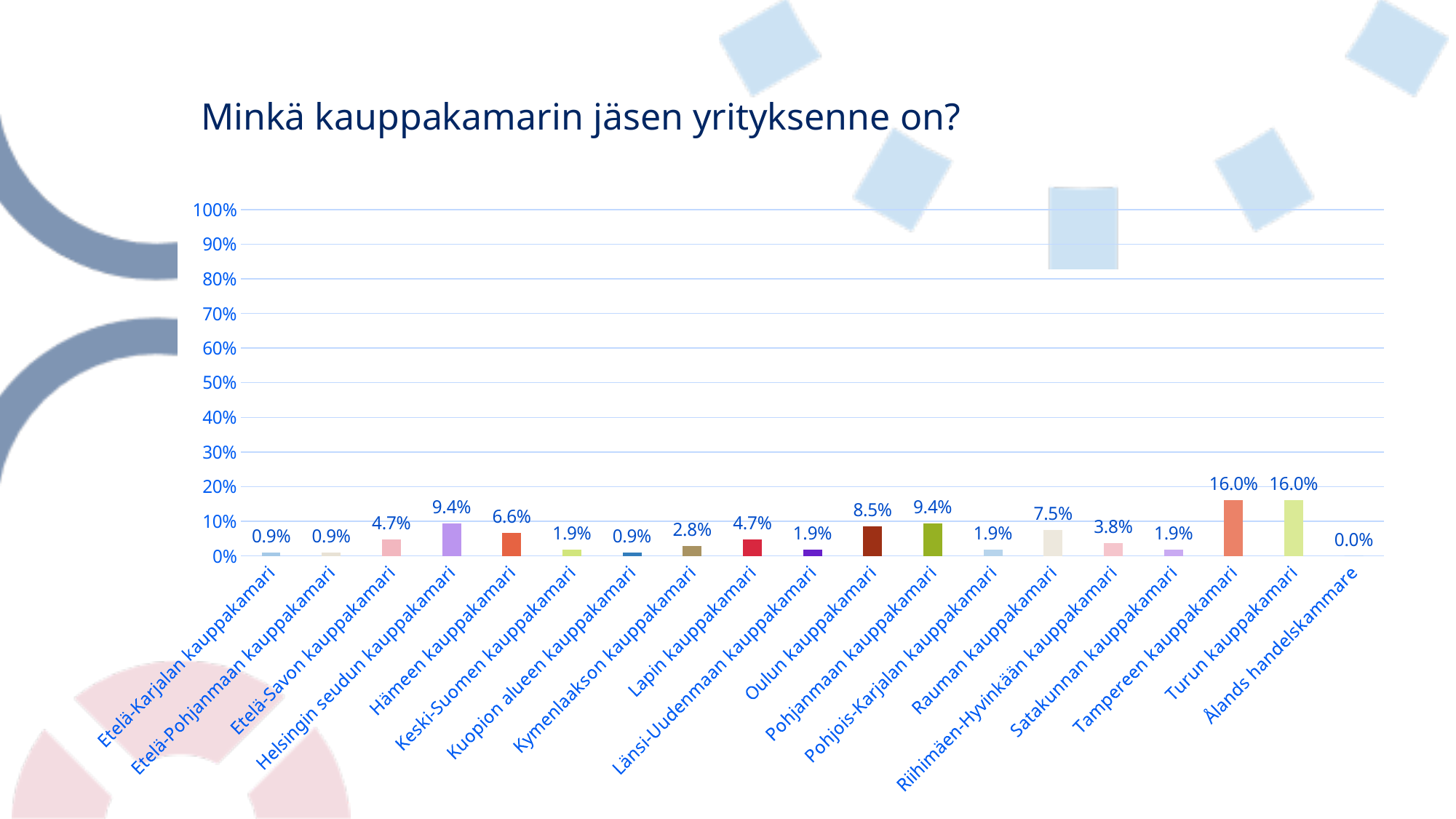
Which is larger, the value for Helsingin seudun kauppakamari or the value for Oulun kauppakamari? Helsingin seudun kauppakamari Which two categories share the highest value? Tampereen kauppakamari and Turun kauppakamari Which category has the lowest value? Ålands handelskammare What is the value for Oulun kauppakamari? 8.5% What is the value for Hämeen kauppakamari? 6.6% What kind of chart is shown on the slide? Bar chart What is the value for Riihimäen-Hyvinkään kauppakamari? 3.8% What is the difference between the values for Turun kauppakamari and Rauman kauppakamari? 8.5% How many categories are shown on the x axis? 19 What is the value for Tampereen kauppakamari? 16.0% What is the value for Kymenlaakson kauppakamari? 2.8% What is the title of the slide? Minkä kauppakamarin jäsen yrityksenne on?